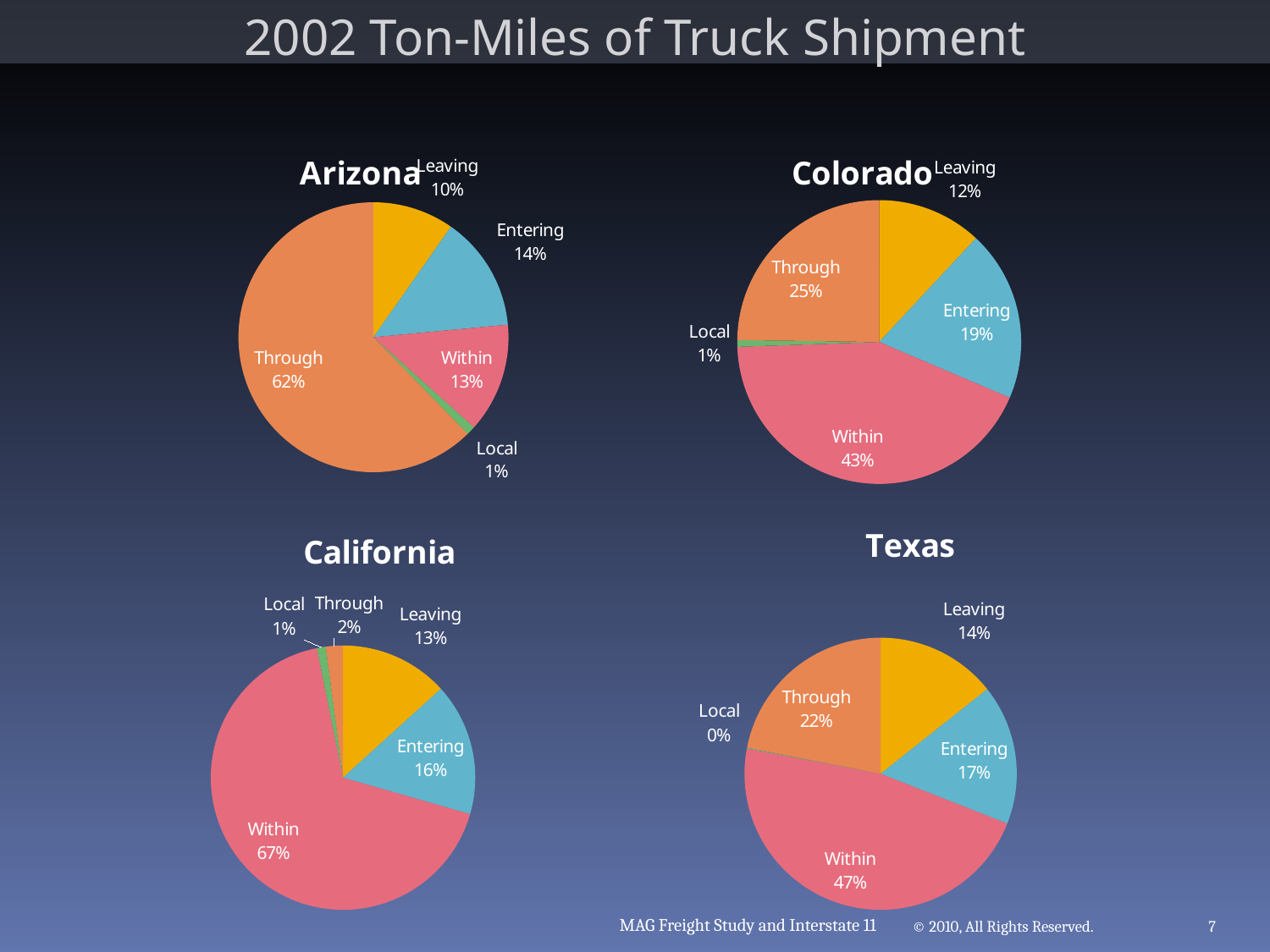
What kind of chart is used for Texas? Pie chart How many categories does the Colorado chart show? 5 In the Colorado chart, what is the difference between the Within and Through shares? 18% In the Arizona chart, which category has the largest share? Through In the California chart, which category has the smallest share? Local In the Arizona chart, what share of ton-miles is Through? 62% What is the title of the slide? 2002 Ton-Miles of Truck Shipment In the Texas chart, what share of ton-miles is Through? 22% In the Colorado chart, what share of ton-miles is Within? 43% In the Texas chart, which is larger, Entering or Leaving? Entering How many pie charts are on the slide? 4 In the California chart, what share of ton-miles is Entering? 16%